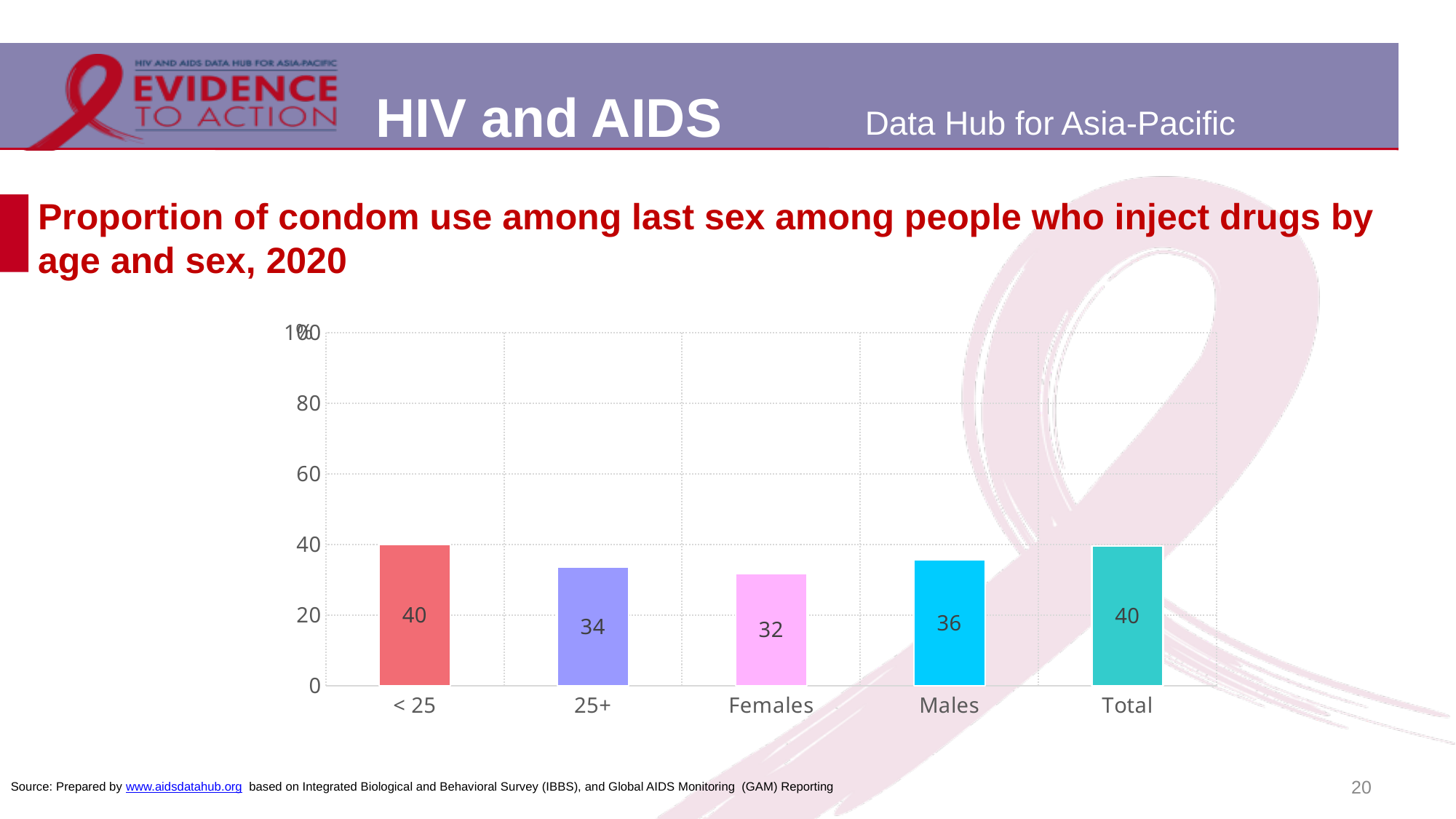
What is the value for Females? 32 What is the value for 25+? 34 Which category has the lowest value? Females What is the value for < 25? 40 Which is larger, the value for Males or the value for 25+? Males Is the value for Females greater or less than 40? less How many categories are shown on the x axis? 5 What is the difference between the values for < 25 and 25+? 6 What is the value for Total? 40 What is the difference between the values for Males and Females? 4 What kind of chart is shown on the slide? bar chart What is the value for Males? 36